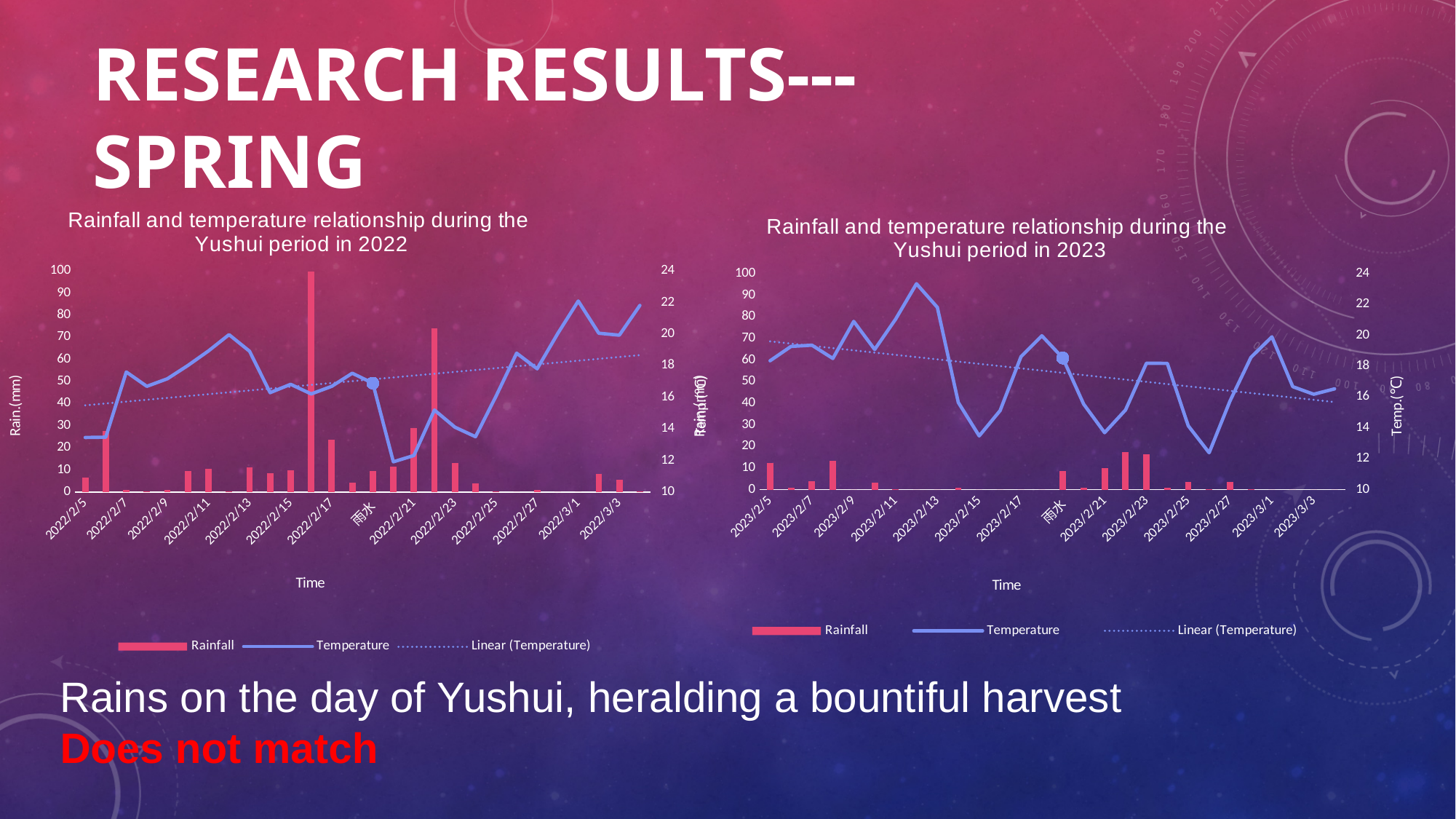
On the 2022 chart, which is higher: the temperature on 2022/3/1 or on 2022/2/5? 2022/3/1 On the 2023 chart, which is higher: the temperature on 2023/2/13 or on 2023/2/27? 2023/2/13 How many series does the legend list on the 'Rainfall and temperature relationship during the Yushui period in 2023' chart? 3 On the 2022 chart, is the rainfall value for 2022/2/17 greater or less than 90? less What is the x-axis title on the 2022 chart? Time On the 2023 chart, does the Linear (Temperature) trendline rise or fall from left to right? fall What kind of chart is the 'Rainfall and temperature relationship during the Yushui period in 2022' chart? A combination bar and line chart On the 2022 chart, does the Linear (Temperature) trendline rise or fall from left to right? rise